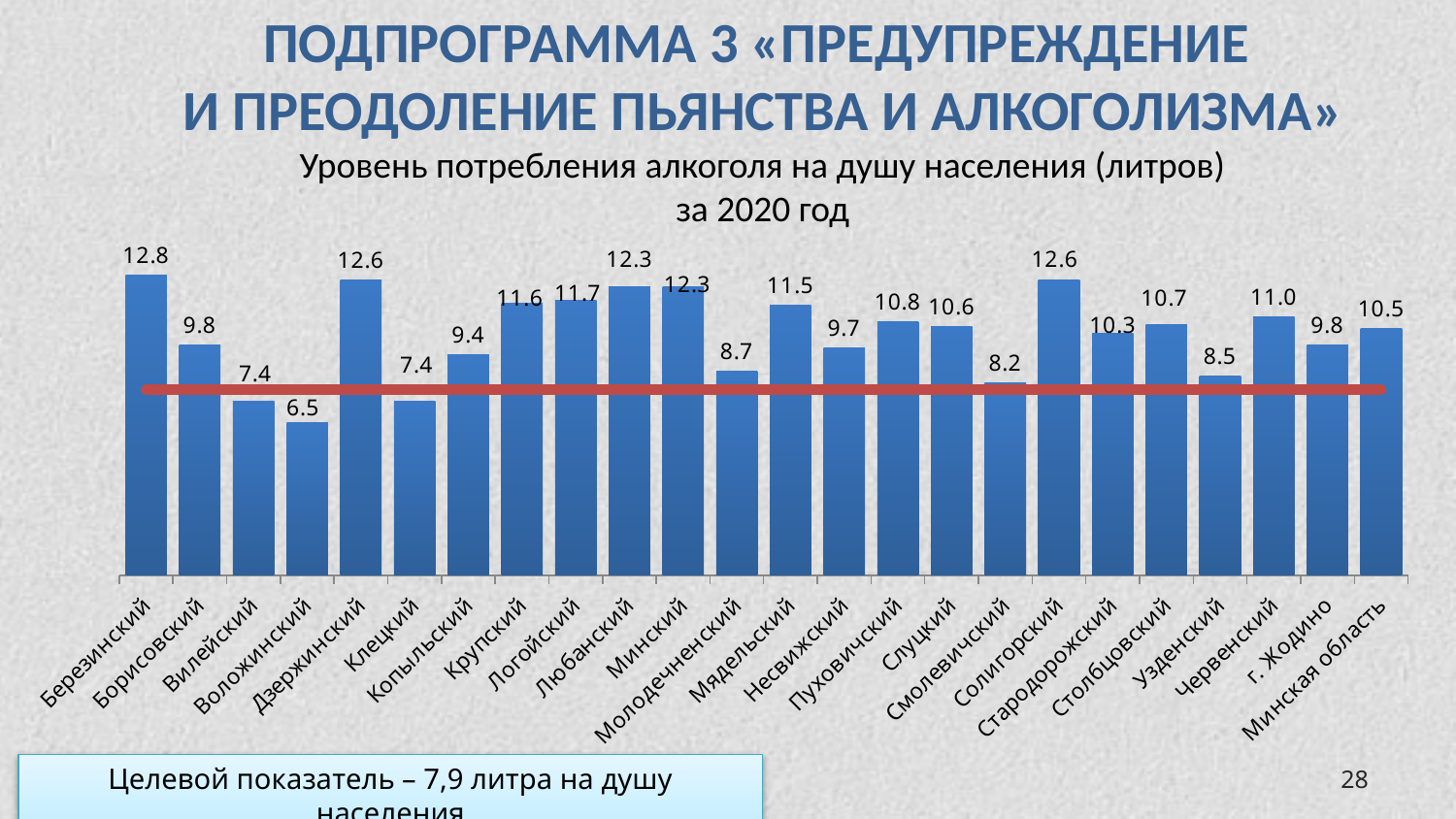
What is the difference between the values for Березинский and Воложинский? 6.3 What is the alcohol consumption value for Березинский? 12.8 Which is larger, the value for Крупский or the value for Узденский? Крупский What is the value shown for Минская область? 10.5 What type of chart is shown on the slide? Bar chart with a horizontal target line (combination bar and line chart) Which district has the lowest alcohol consumption per capita? Воложинский What is the value shown for г. Жодино? 9.8 What is the difference between the values for Минский and Молодечненский? 3.6 What is the value shown for Солигорский? 12.6 Which district has the highest alcohol consumption per capita? Березинский How many districts/categories are shown on the chart? 24 What target value (целевой показатель) does the slide state for alcohol consumption per capita? 7,9 литра